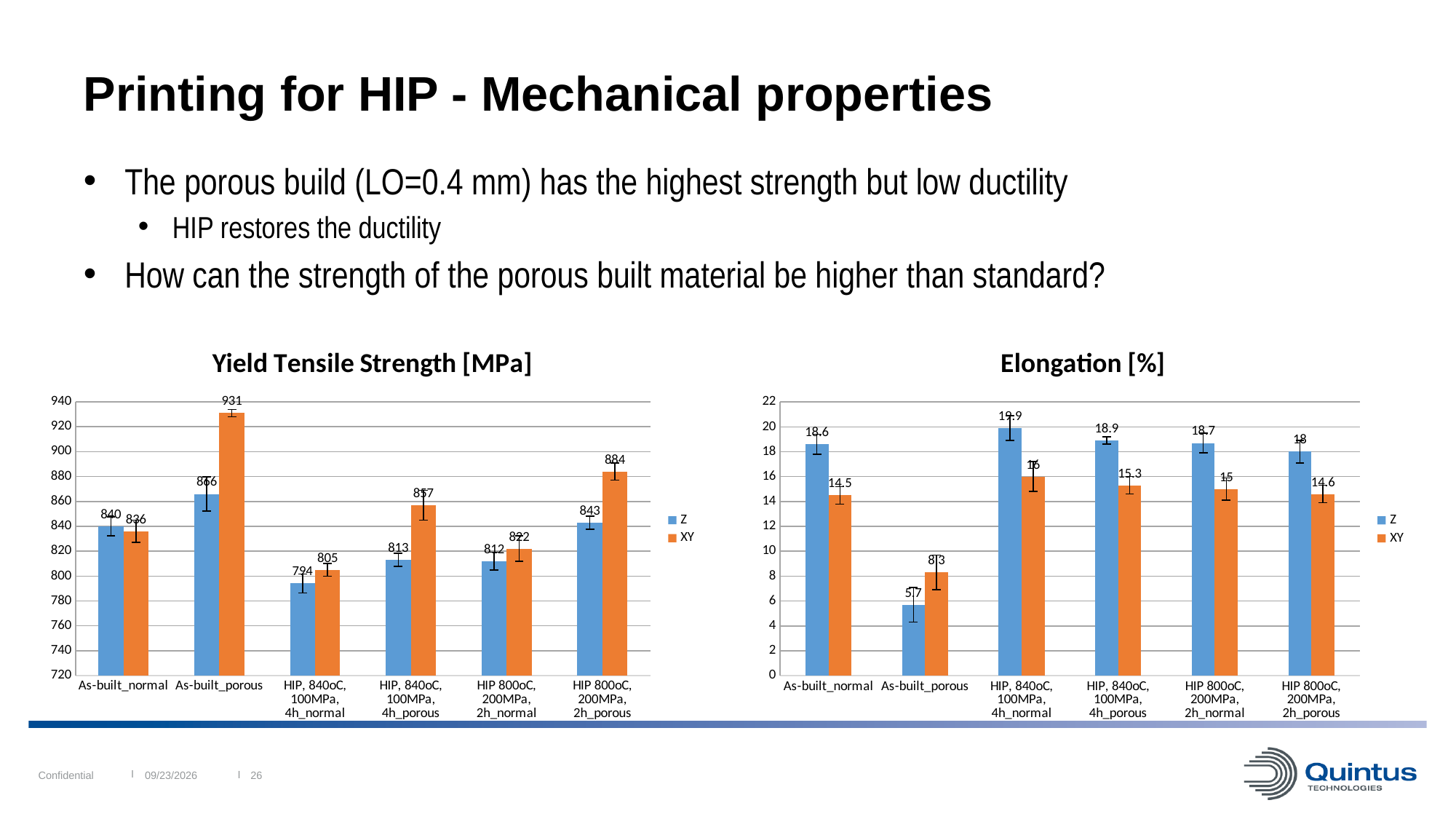
In the Elongation [%] chart, is the Z value for HIP, 840oC, 100MPa, 4h_normal greater or less than 18? greater In the Yield Tensile Strength [MPa] chart, what is the difference between the XY value for As-built_porous and the XY value for HIP, 840oC, 100MPa, 4h_normal? 126 How many categories are shown on the x axis of the Elongation [%] chart? 6 In the Yield Tensile Strength [MPa] chart, what is the XY value for As-built_porous? 931 In the Elongation [%] chart, what is the Z value for As-built_normal? 18.6 In the Yield Tensile Strength [MPa] chart, which category has the lowest Z value? HIP, 840oC, 100MPa, 4h_normal In the Elongation [%] chart, what is the XY value for HIP, 840oC, 100MPa, 4h_porous? 15.3 In the Yield Tensile Strength [MPa] chart, which category has the highest XY value? As-built_porous How many series does the legend of the Yield Tensile Strength [MPa] chart list? 2 In the Elongation [%] chart, which category has the lowest Z value? As-built_porous In the Elongation [%] chart, for HIP 800oC, 200MPa, 2h_normal, which series has the larger value, Z or XY? Z In the Yield Tensile Strength [MPa] chart, what is the Z value for As-built_normal? 840